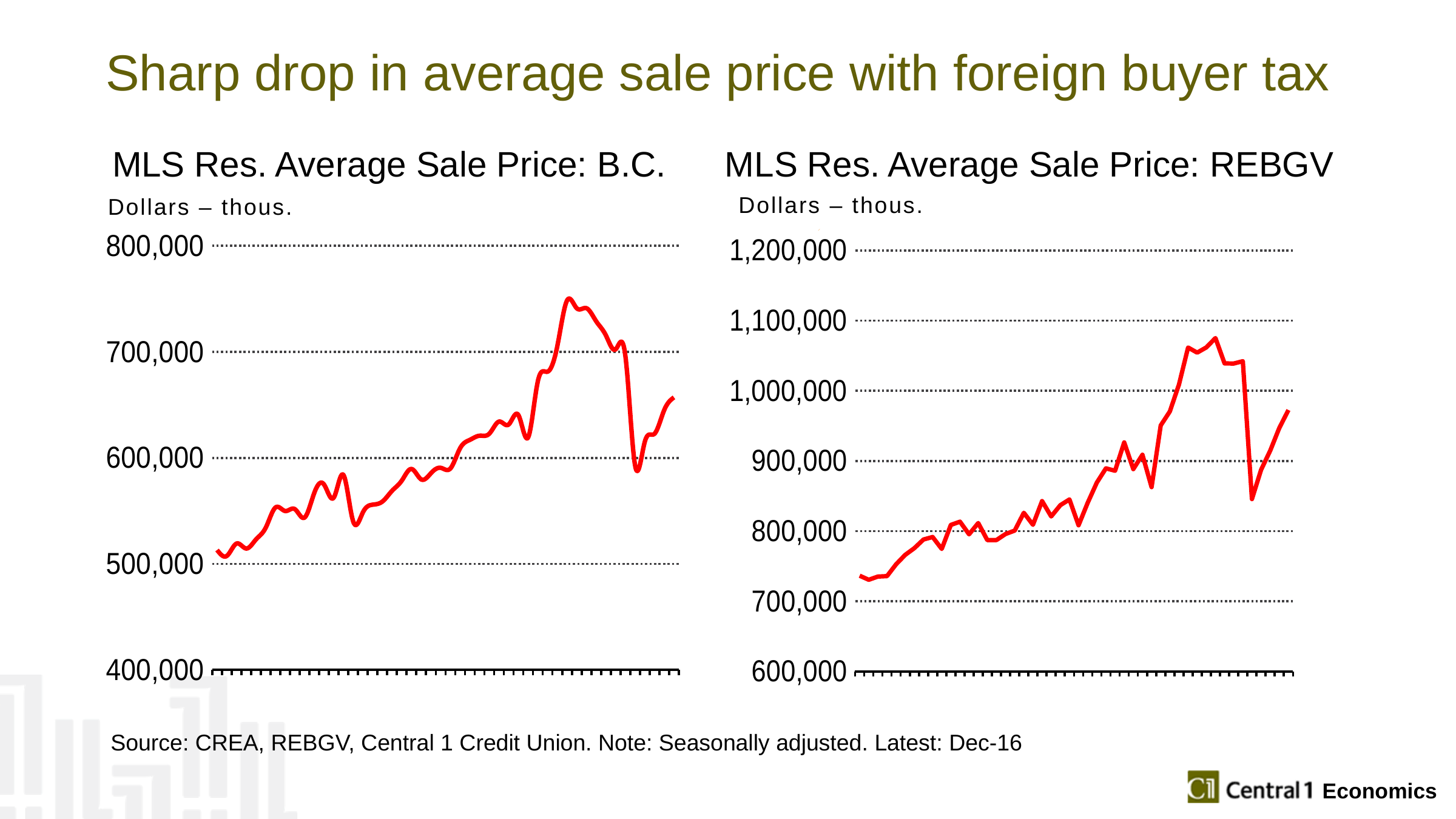
What unit label is shown above the y axis of the 'MLS Res. Average Sale Price: B.C.' chart? Dollars – thous. What is the highest y-axis tick value shown on the 'MLS Res. Average Sale Price: REBGV' chart? 1,200,000 How many charts are shown on the slide? 2 In the 'MLS Res. Average Sale Price: B.C.' chart, is the peak value greater or less than 700,000? greater In the 'MLS Res. Average Sale Price: REBGV' chart, is the peak value greater or less than 1,100,000? less In the 'MLS Res. Average Sale Price: REBGV' chart, is the peak value greater or less than 1,000,000? greater What kind of chart is the 'MLS Res. Average Sale Price: B.C.' chart? line chart In the 'MLS Res. Average Sale Price: REBGV' chart, do values overall rise or fall from the start to the end of the series? rise In the 'MLS Res. Average Sale Price: B.C.' chart, do values overall rise or fall from the start to the end of the series? rise What kind of chart is the 'MLS Res. Average Sale Price: REBGV' chart? line chart